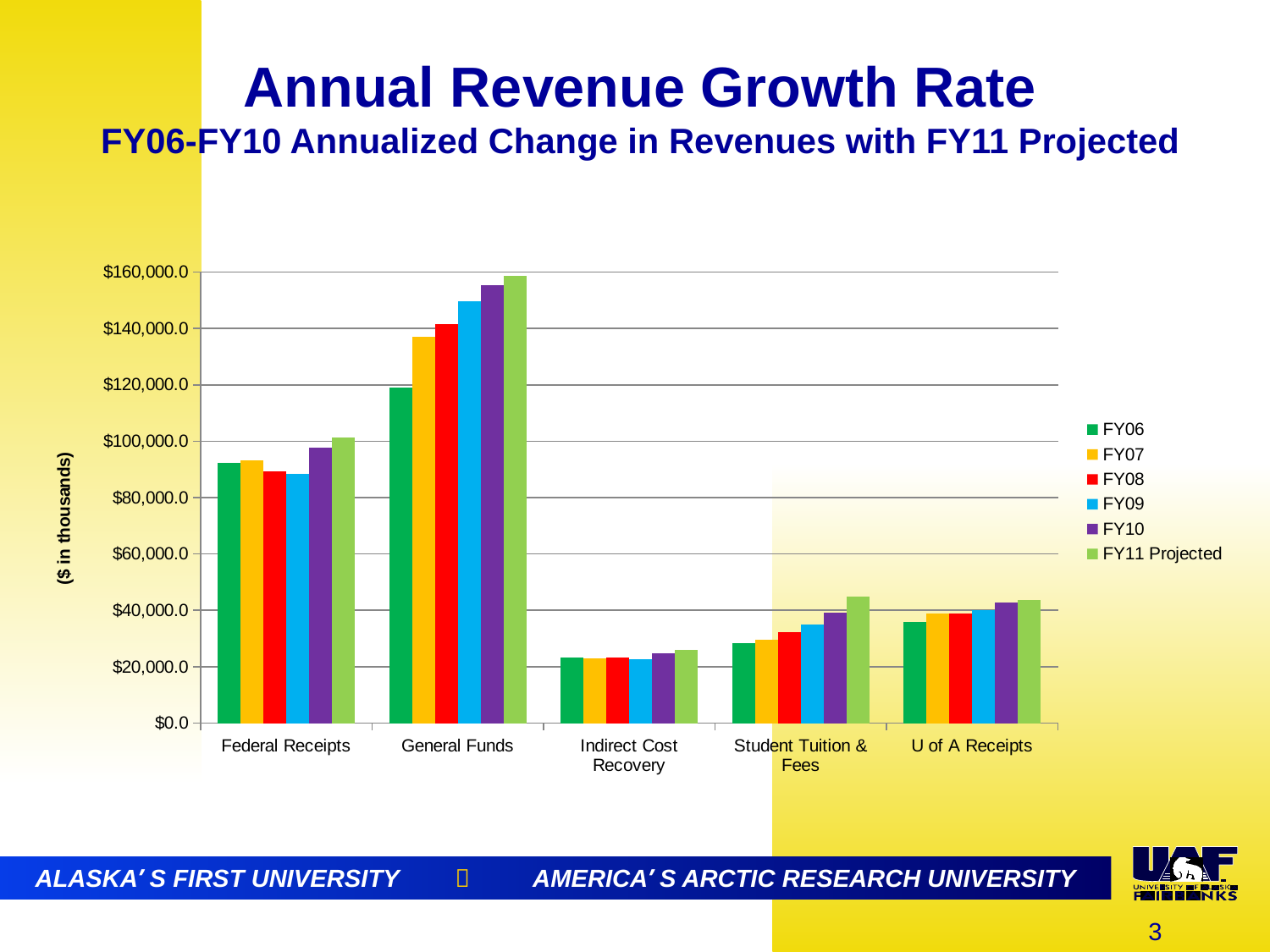
Is the FY11 Projected value for General Funds greater or less than $140,000.0? greater How many series does the legend list? 6 Which revenue category has the lowest bars overall? Indirect Cost Recovery Is the FY06 value for Federal Receipts greater or less than $100,000.0? less What is the label on the vertical axis? ($ in thousands) Do the General Funds values rise or fall from FY06 to FY11 Projected? rise What kind of chart is shown on the slide? Bar chart Which revenue category has the highest bars overall? General Funds Is the FY10 value for Indirect Cost Recovery greater or less than $40,000.0? less How many revenue categories are shown on the x axis? 5 Do the Student Tuition & Fees values rise or fall from FY06 to FY11 Projected? rise Which is larger for FY06: Student Tuition & Fees or U of A Receipts? U of A Receipts